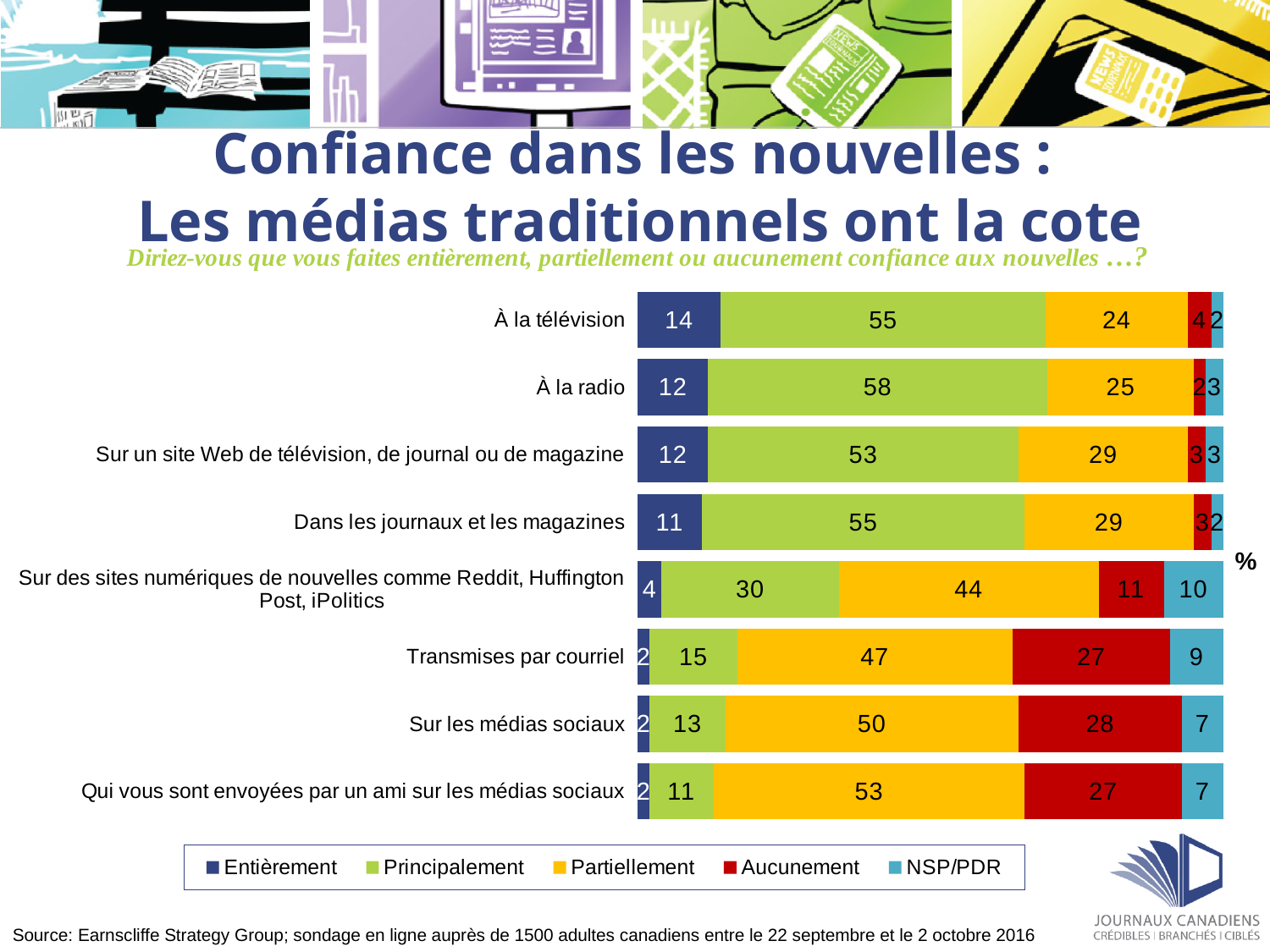
What is the difference between the 'Principalement' values for 'À la radio' and 'Transmises par courriel'? 43 What is the total of the stacked bar for 'Sur les médias sociaux'? 100 What is the 'Partiellement' value for 'Sur des sites numériques de nouvelles comme Reddit, Huffington Post, iPolitics'? 44 Which is larger: the 'Aucunement' value for 'Transmises par courriel' or for 'À la télévision'? Transmises par courriel What is the 'Principalement' value for 'À la radio'? 58 Which category has the highest 'Entièrement' value? À la télévision What type of chart is shown on the slide? stacked bar chart Which legend entry is shown in red? Aucunement What is the 'Aucunement' value for 'Sur les médias sociaux'? 28 How many series does the legend list? 5 How many categories (news sources) are shown in the chart? 8 Which category has the lowest 'Principalement' value? Qui vous sont envoyées par un ami sur les médias sociaux